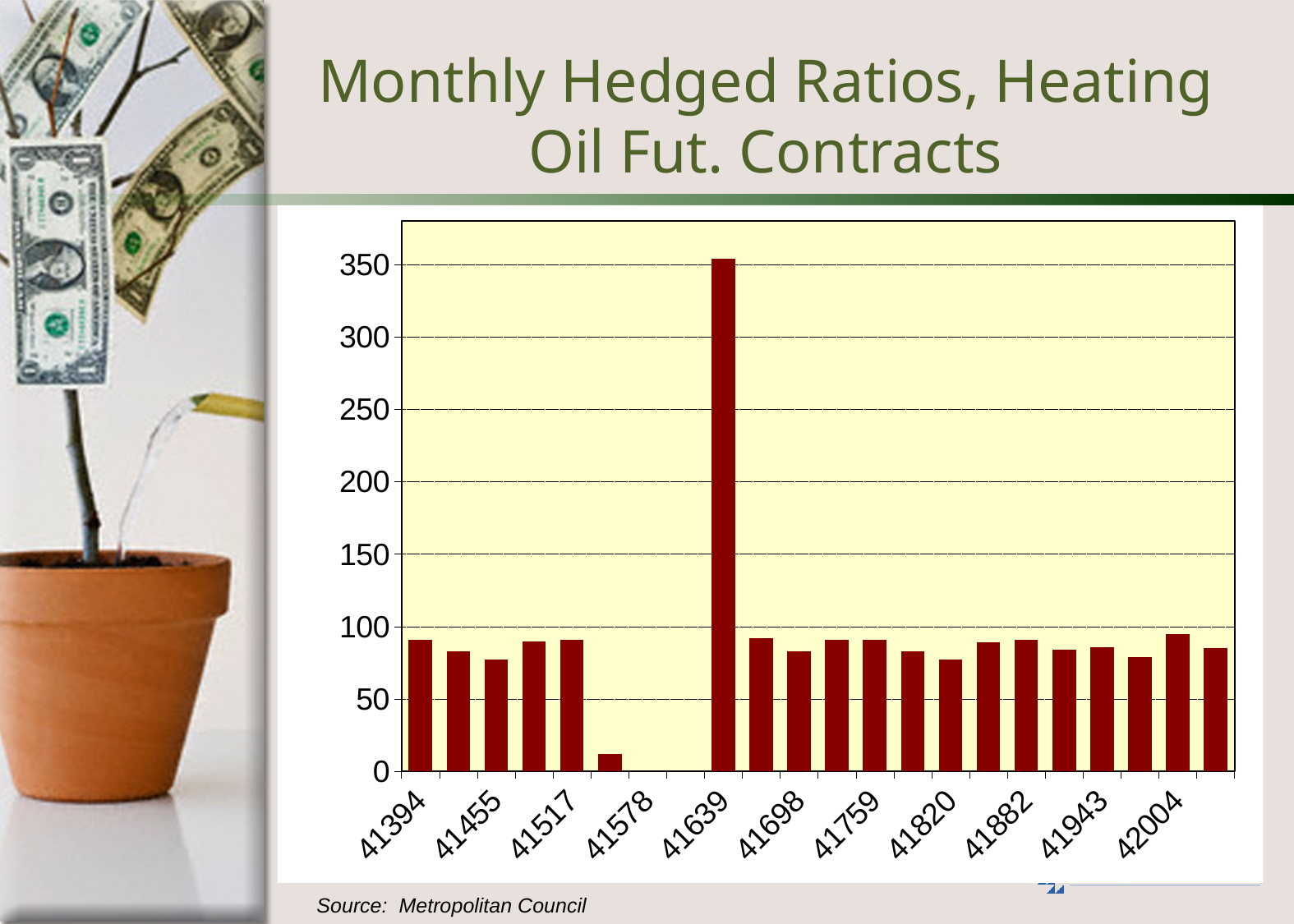
What kind of chart is shown on the slide? bar chart Is the value for 41759 greater or less than 50? greater Is the value for 41639 greater or less than 300? greater How many category labels are shown on the x axis? 11 What is the highest tick value shown on the y axis? 350 Is the value for 41394 greater or less than 100? less Which is larger, the value for 41639 or the value for 41698? 41639 Which category has the highest bar in the chart? 41639 Which is larger, the value for 41394 or the value for 41455? 41394 What is the title of the chart on the slide? Monthly Hedged Ratios, Heating Oil Fut. Contracts